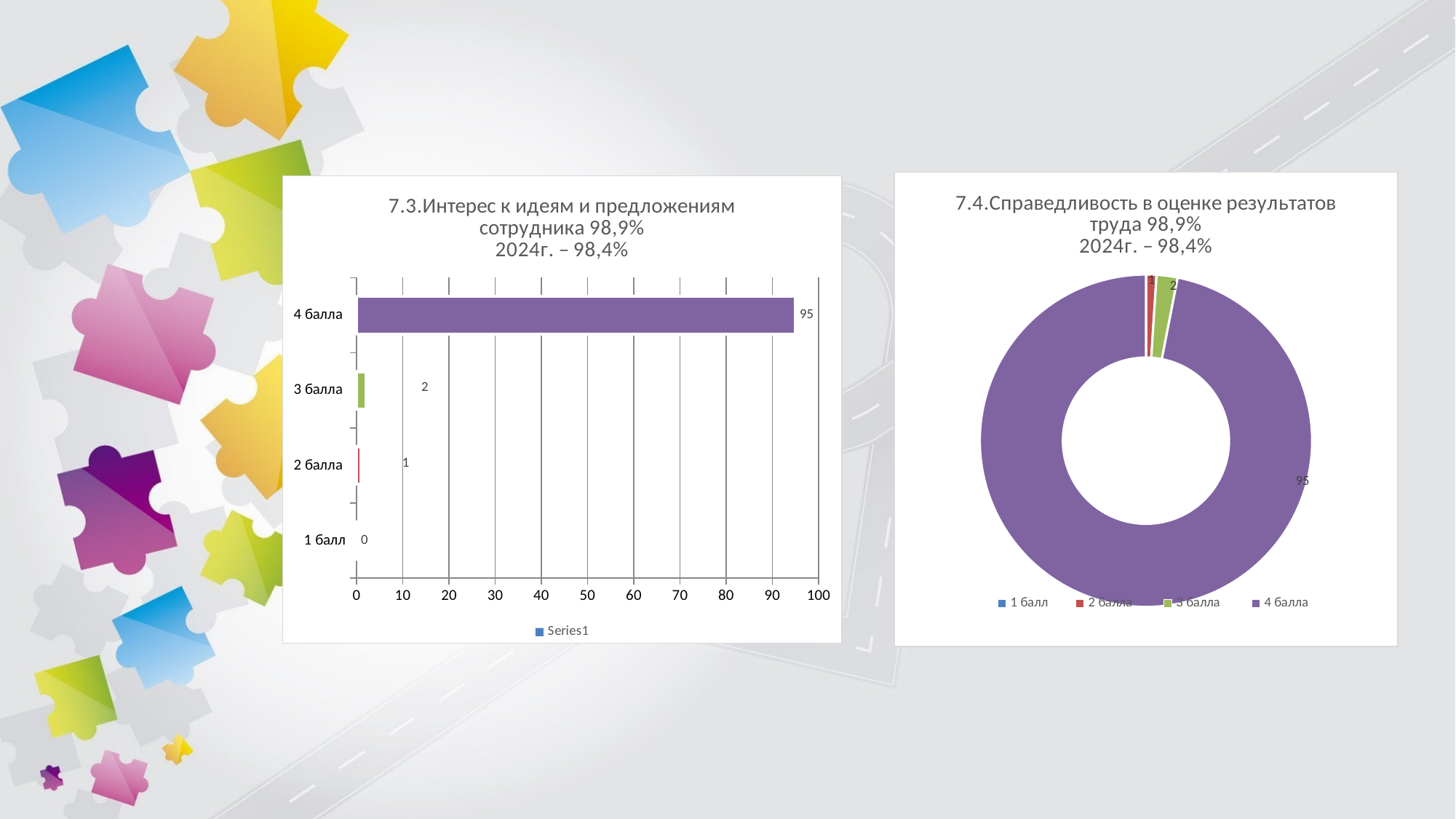
In the chart titled "7.3.Интерес к идеям и предложениям сотрудника", what is the value for 3 балла? 2 In the chart titled "7.3.Интерес к идеям и предложениям сотрудника", what is the value for 4 балла? 95 In the chart titled "7.3.Интерес к идеям и предложениям сотрудника", which category has the highest value? 4 балла What kind of chart is the one on the left of the slide? Bar chart In the chart titled "7.3.Интерес к идеям и предложениям сотрудника", which category has the lowest value? 1 балл In the chart titled "7.3.Интерес к идеям и предложениям сотрудника", what is the difference between the values for 4 балла and 3 балла? 93 What kind of chart is the one titled "7.4.Справедливость в оценке результатов труда"? Doughnut chart In the chart titled "7.4.Справедливость в оценке результатов труда", what is the value labelled on the 4 балла slice? 95 In the chart titled "7.3.Интерес к идеям и предложениям сотрудника", what is the value for 2 балла? 1 In the chart titled "7.3.Интерес к идеям и предложениям сотрудника", how many categories are shown on the vertical axis? 4 In the chart titled "7.3.Интерес к идеям и предложениям сотрудника", what is the value for 1 балл? 0 How many entries does the legend of the chart titled "7.4.Справедливость в оценке результатов труда" list? 4